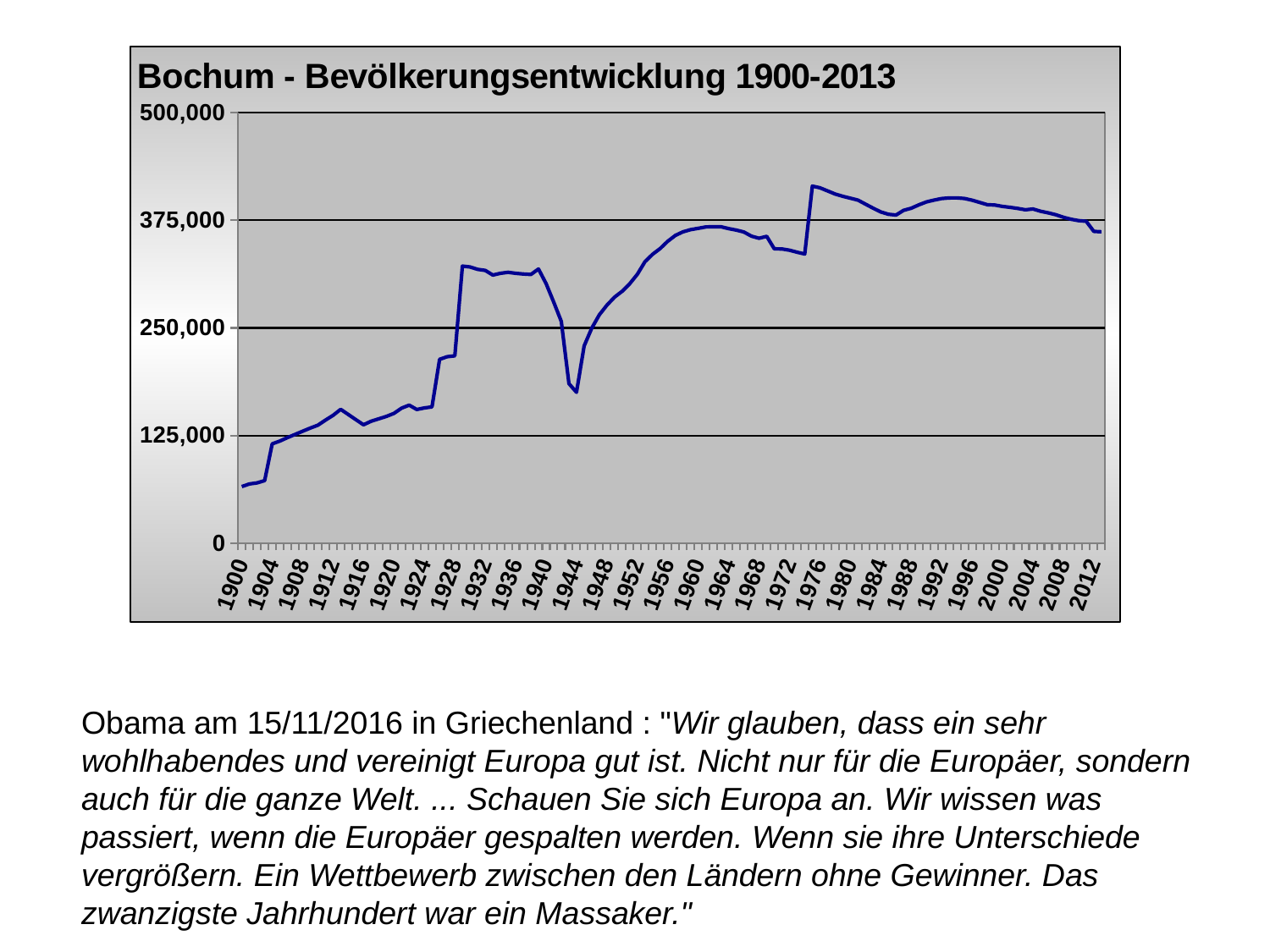
Does the population rise or fall between 1900 and 1912? rise Is the value for 1976 greater or less than 375,000? greater Which is larger, the value for 1944 or the value for 1960? 1960 Is the value for 1932 greater or less than 250,000? greater Is the value for 1944 greater or less than 250,000? less What kind of chart is shown on the slide? line chart How many year labels are shown on the x axis? 29 What is the title of the chart? Bochum - Bevölkerungsentwicklung 1900-2013 Does the population rise or fall between 1940 and 1944? fall Which year has the lowest population value on the chart? 1900